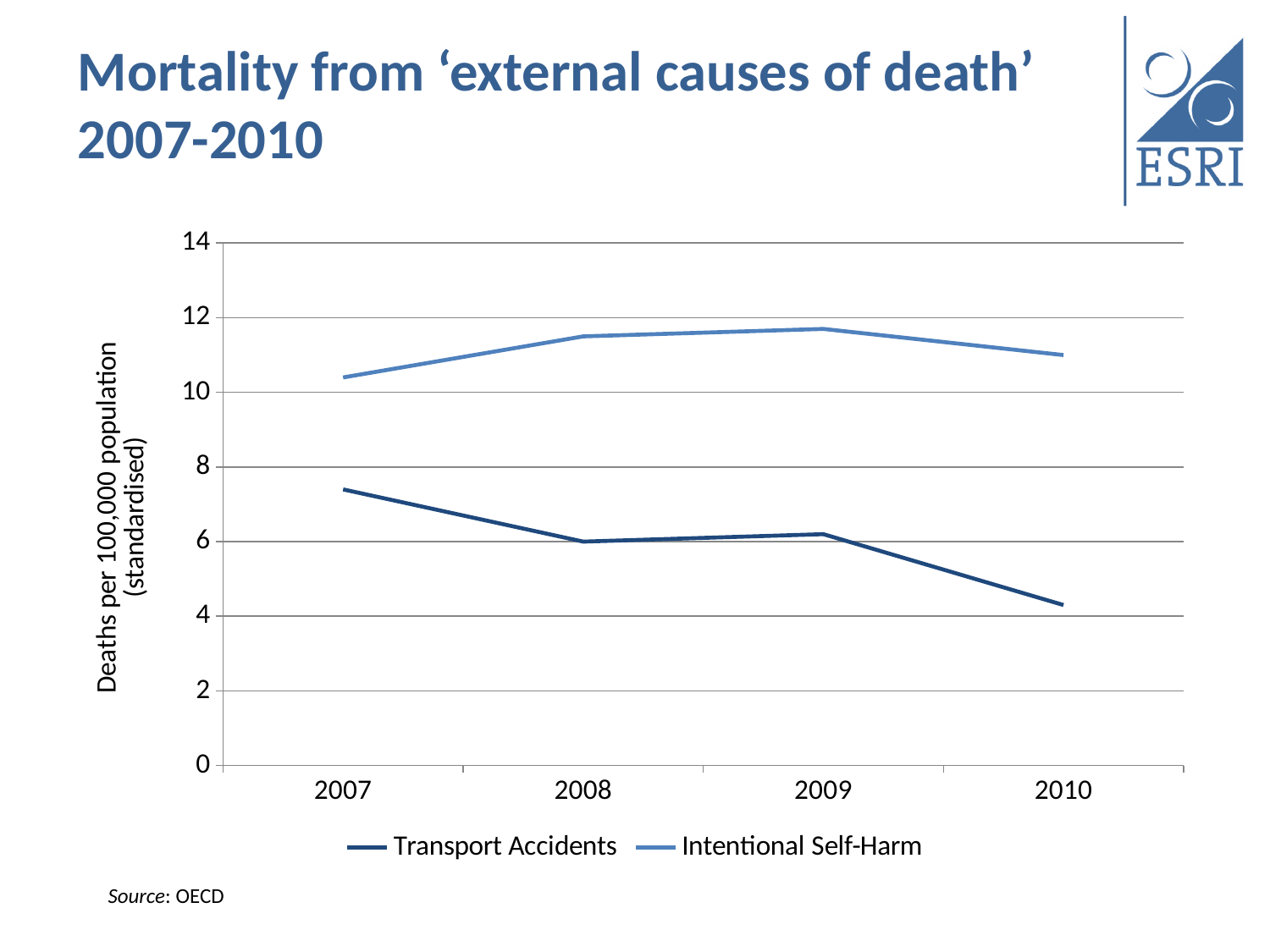
Is the value for Transport Accidents in 2007 greater or less than 8? less What kind of chart is shown on the slide? line chart What is the label on the vertical axis? Deaths per 100,000 population (standardised) In 2010, which series has the larger value, Transport Accidents or Intentional Self-Harm? Intentional Self-Harm Is the value for Intentional Self-Harm in 2009 greater or less than 12? less How many series does the legend list? 2 Is the value for Intentional Self-Harm in 2007 greater or less than 10? greater Which year has the highest value for Transport Accidents? 2007 Which year has the lowest value for Intentional Self-Harm? 2007 How many years are plotted along the x axis? 4 Which year has the lowest value for Transport Accidents? 2010